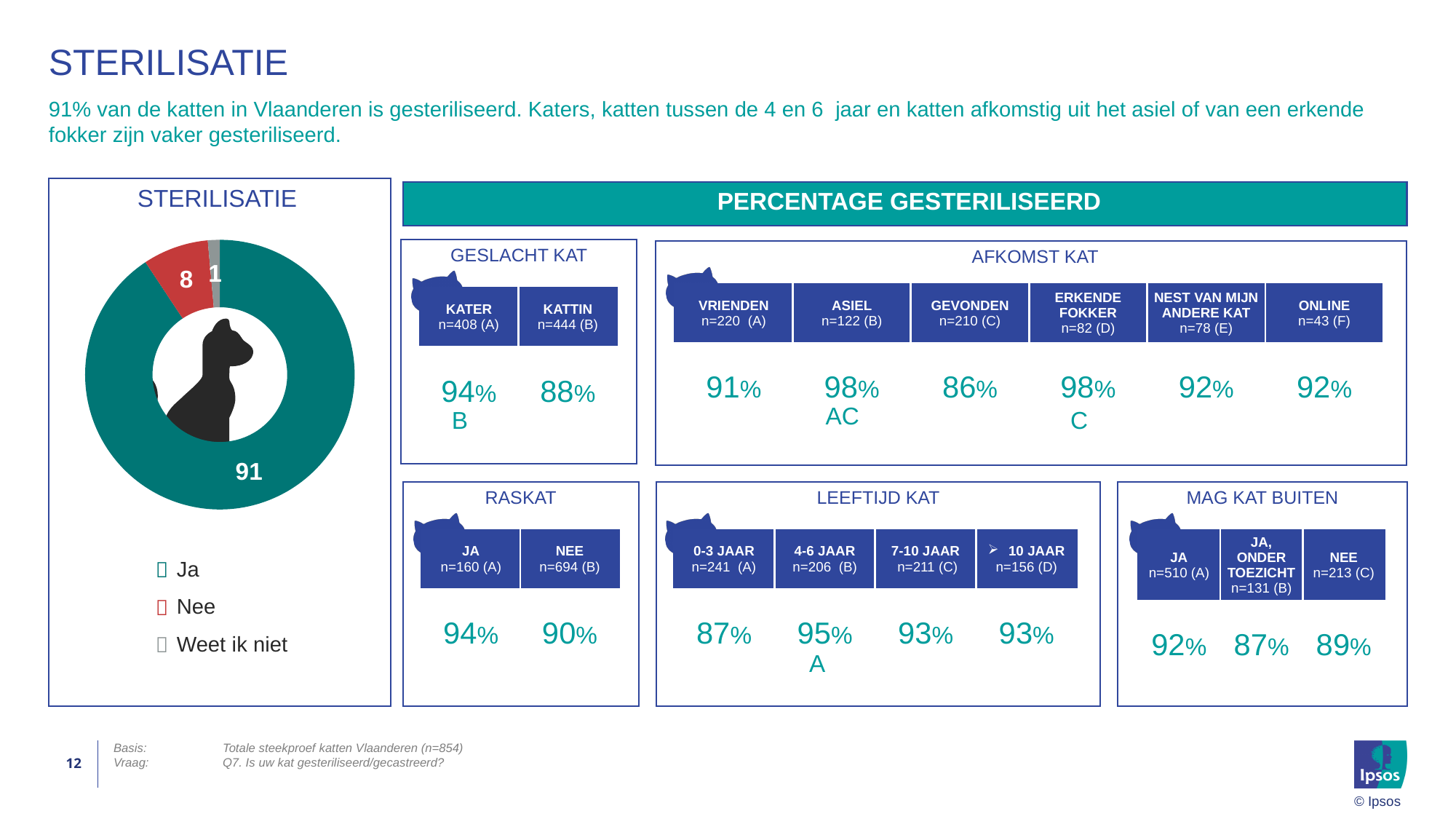
In the STERILISATIE donut chart, which is larger: Nee or Weet ik niet? Nee How many categories does the STERILISATIE donut chart show? 3 In the STERILISATIE donut chart, what do the three slice values add up to? 100 In the STERILISATIE donut chart, what colour is the Nee slice? red What are the legend entries of the STERILISATIE donut chart? Ja, Nee, Weet ik niet In the STERILISATIE donut chart, what value is shown for Nee? 8 In the STERILISATIE donut chart, what value is shown for Ja? 91 In the STERILISATIE donut chart, which category has the smallest slice? Weet ik niet In the STERILISATIE donut chart, which category has the largest slice? Ja What kind of chart is the STERILISATIE chart on the left of the slide? donut (pie) chart In the STERILISATIE donut chart, what is the difference between the values for Ja and Nee? 83 In the STERILISATIE donut chart, what value is shown for Weet ik niet? 1